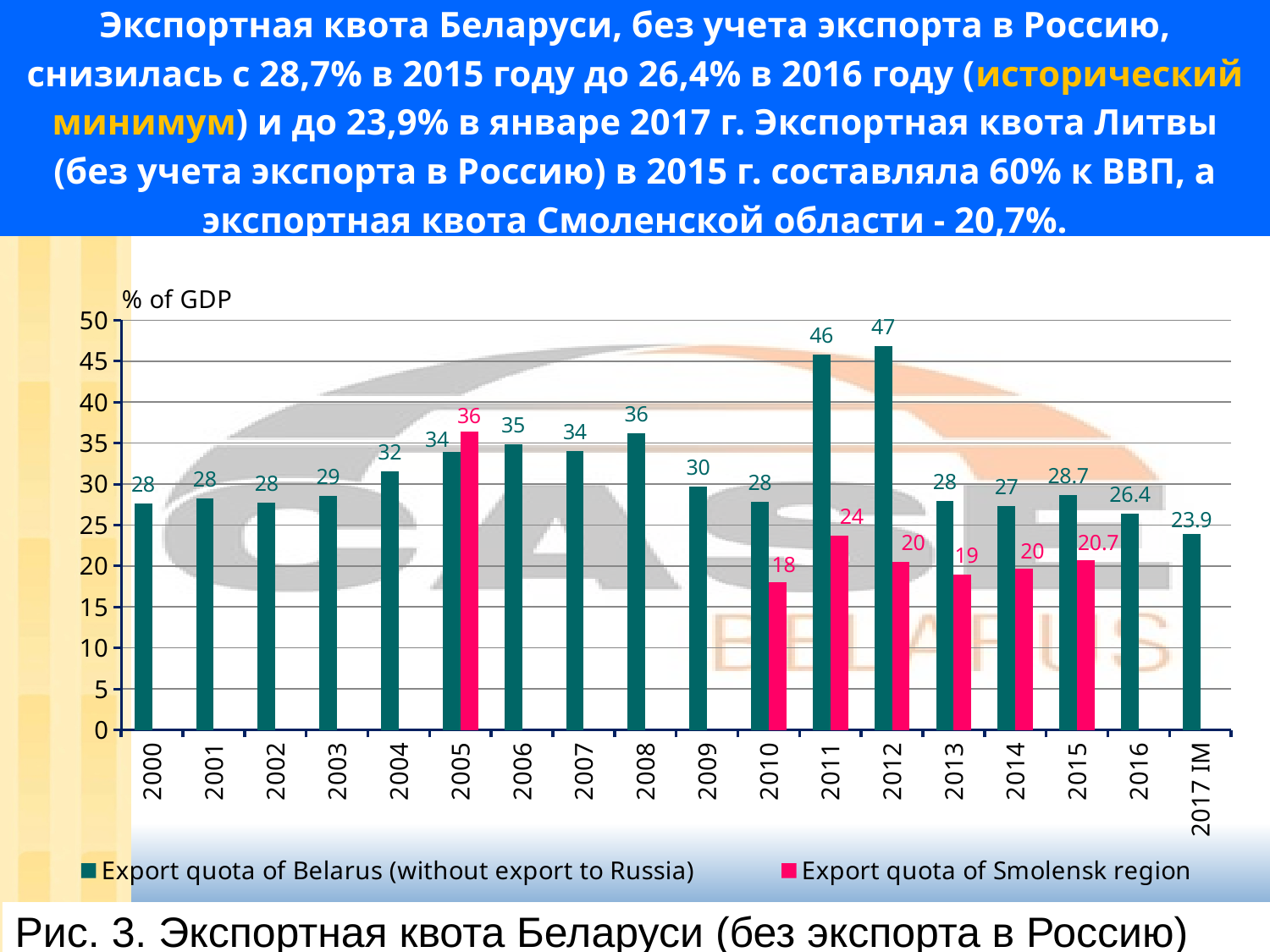
What is the difference between the export quota of Belarus (without export to Russia) and the export quota of the Smolensk region in 2015? 8 What kind of chart is shown on the slide? Bar chart What unit is shown on the vertical axis label? % of GDP In which year is the export quota of the Smolensk region lowest? 2010 What is the export quota of Belarus (without export to Russia) in 2012? 47 How many series does the legend list? 2 What is the export quota of Belarus (without export to Russia) for 2017 IM? 23.9 How many years (categories) are shown on the x axis? 18 Which is larger in 2005: the export quota of Belarus (without export to Russia) or the export quota of the Smolensk region? Export quota of Smolensk region In which year is the export quota of Belarus (without export to Russia) highest? 2012 Does the export quota of Belarus (without export to Russia) rise or fall from 2015 to 2017 IM? Fall What is the export quota of the Smolensk region in 2011? 24